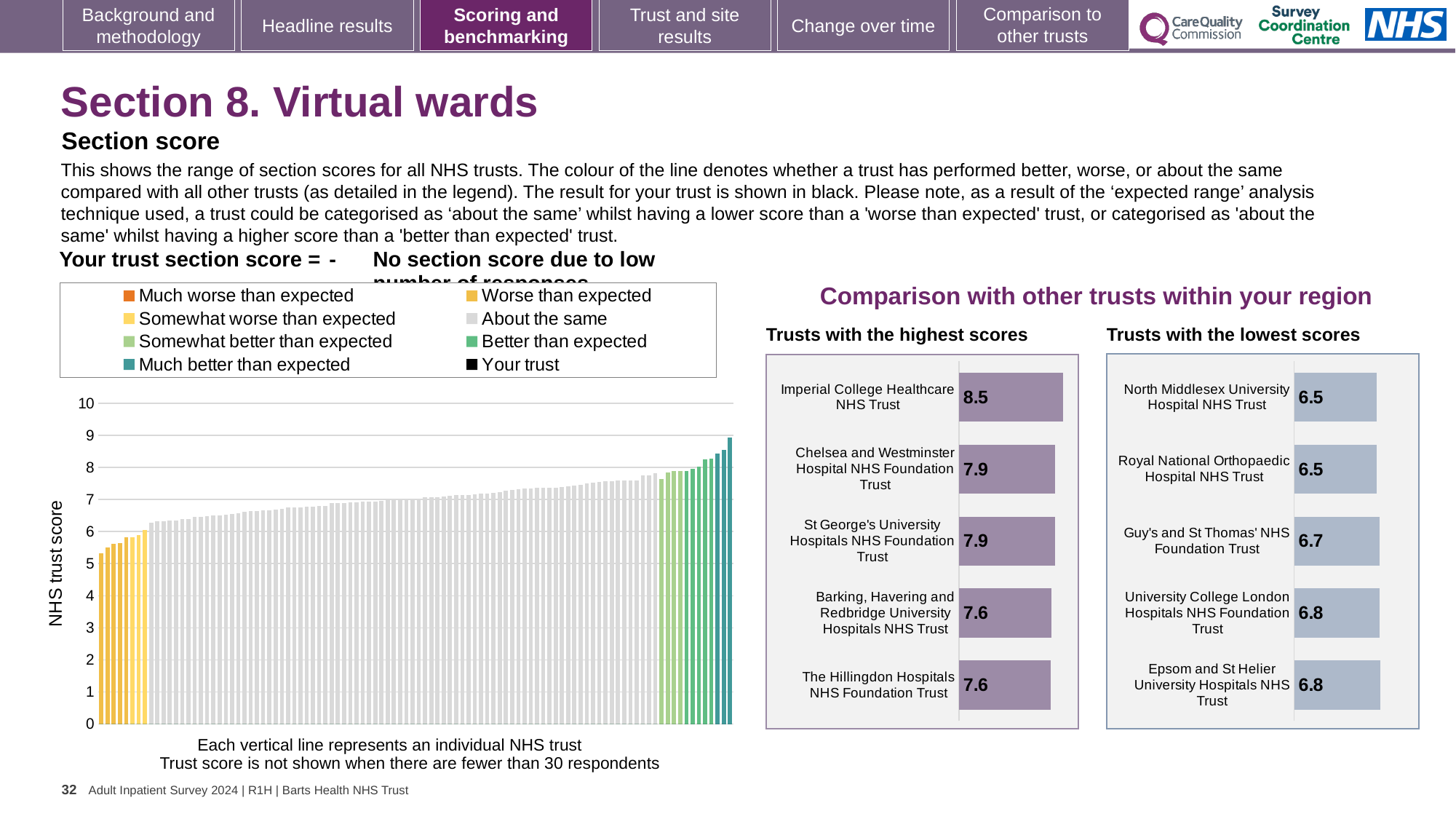
In the 'Trusts with the lowest scores' chart, what is the score for Epsom and St Helier University Hospitals NHS Trust? 6.8 In the 'Trusts with the highest scores' chart, which trust has the highest score? Imperial College Healthcare NHS Trust In the 'Trusts with the lowest scores' chart, what is the difference between the scores of University College London Hospitals NHS Foundation Trust and North Middlesex University Hospital NHS Trust? 0.3 In the 'Trusts with the highest scores' chart, what is the score for Imperial College Healthcare NHS Trust? 8.5 In the 'Trusts with the highest scores' chart, what is the score for The Hillingdon Hospitals NHS Foundation Trust? 7.6 In the large 'NHS trust score' chart on the left, is the value of the tallest bar greater or less than 8? greater How many entries does the legend of the large 'NHS trust score' chart on the left list? 8 In the large 'NHS trust score' chart on the left, do the bar values rise or fall from left to right? rise In the 'Trusts with the lowest scores' chart, what is the score for Guy's and St Thomas' NHS Foundation Trust? 6.7 In the 'Trusts with the highest scores' chart, what is the difference between the scores of Imperial College Healthcare NHS Trust and Barking, Havering and Redbridge University Hospitals NHS Trust? 0.9 In the 'Trusts with the lowest scores' chart, how many trusts are shown? 5 Which is larger: the score for Chelsea and Westminster Hospital NHS Foundation Trust in the highest scores chart, or the score for Guy's and St Thomas' NHS Foundation Trust in the lowest scores chart? Chelsea and Westminster Hospital NHS Foundation Trust